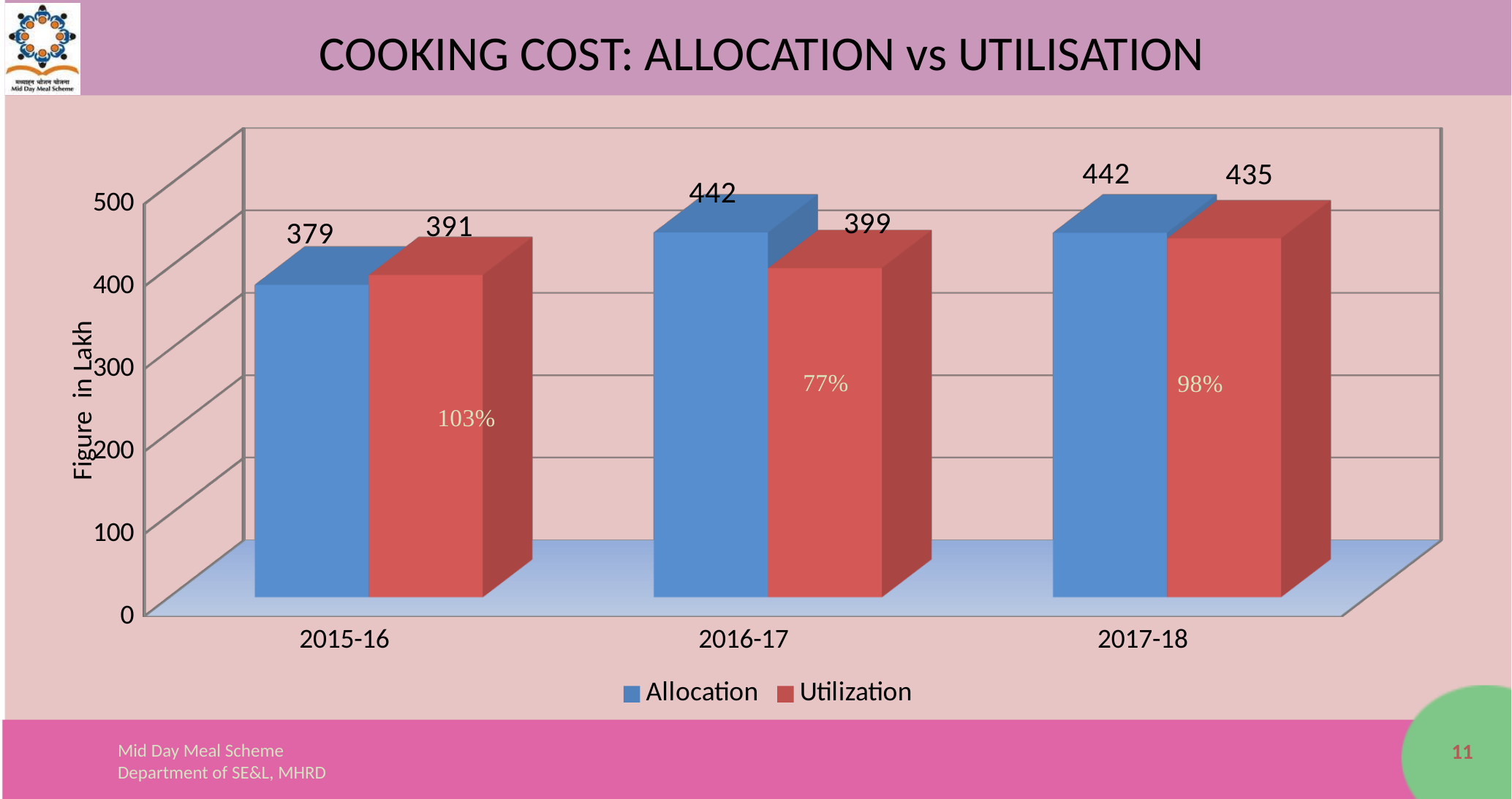
Which year has the highest Utilization value? 2017-18 What is the difference between Allocation and Utilization in 2016-17? 43 What is the Utilization value for 2016-17? 399 What is the Utilization value for 2017-18? 435 How many series does the legend list? 2 How many years are shown on the x axis? 3 Which is larger in 2015-16, Allocation or Utilization? Utilization Which year has the lowest Allocation value? 2015-16 What is the Allocation value for 2016-17? 442 What kind of chart is shown on the slide? Bar chart What is the title of the chart? COOKING COST: ALLOCATION vs UTILISATION What is the Allocation value for 2015-16? 379